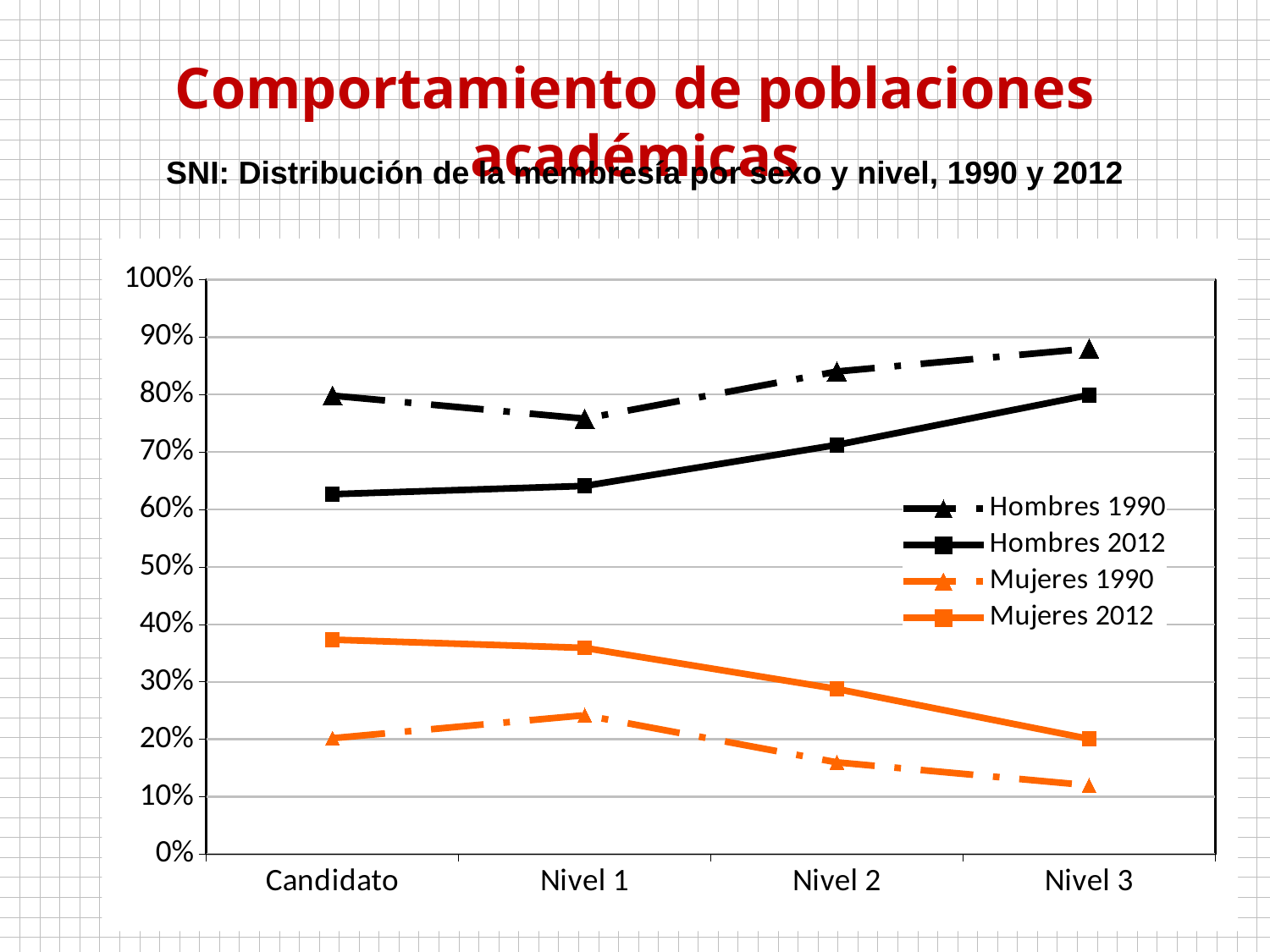
What kind of chart is shown on the slide? line chart At which category does the Mujeres 1990 series reach its lowest value? Nivel 3 How many series does the legend list? 4 Which is larger at Candidato: Hombres 1990 or Hombres 2012? Hombres 1990 Is the value for Mujeres 2012 at Candidato greater or less than 40%? less How many categories are shown on the x axis? 4 Is the value for Mujeres 1990 at Nivel 3 greater or less than 10%? greater Does the Mujeres 2012 series rise or fall from Candidato to Nivel 3? fall At which category does the Hombres 2012 series reach its highest value? Nivel 3 What is the subtitle of the chart? SNI: Distribución de la membresía por sexo y nivel, 1990 y 2012 Is the value for Hombres 1990 at Nivel 3 greater or less than 90%? less